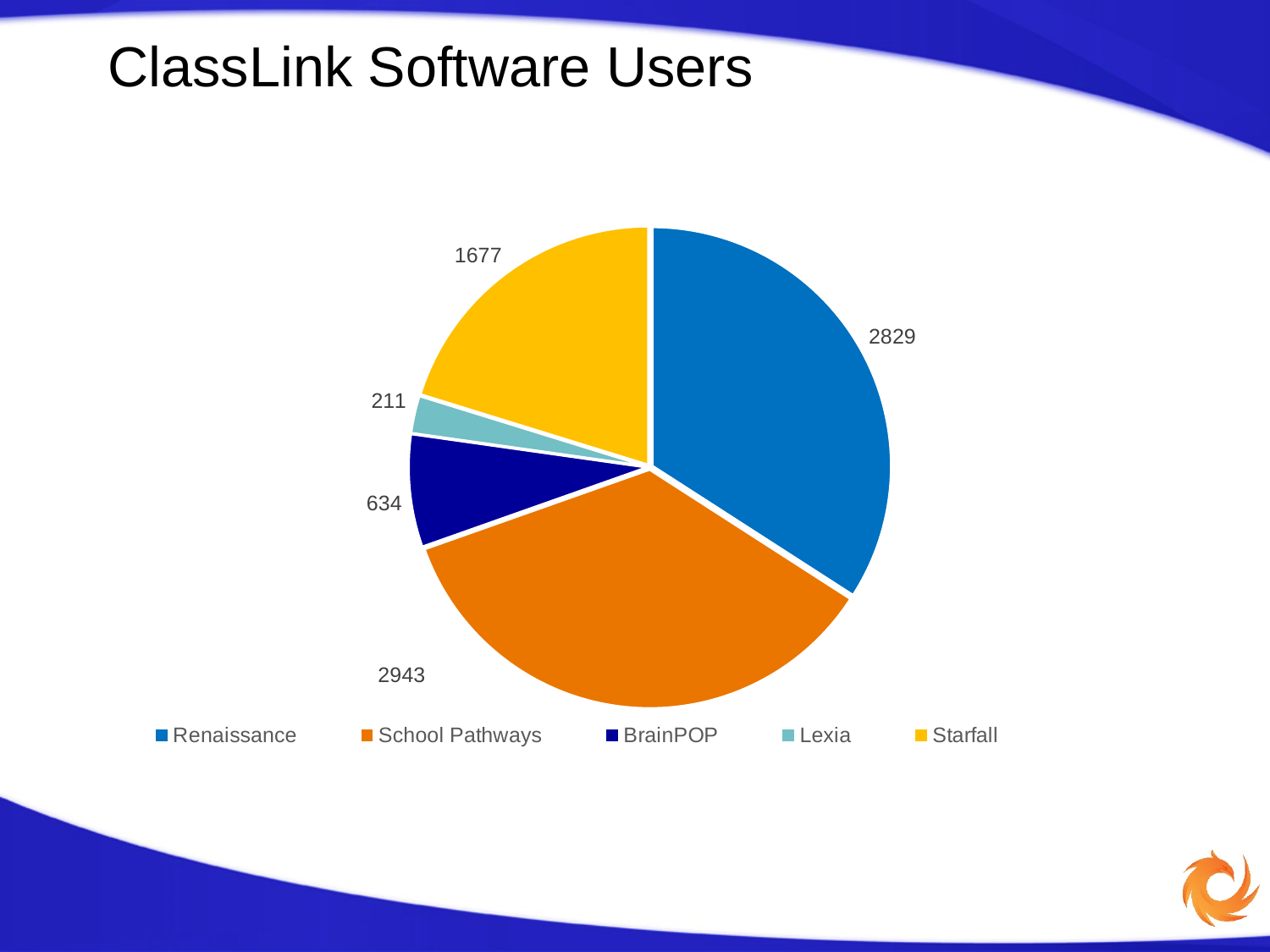
What is the value for Starfall? 1677 What is the value for Lexia? 211 What is the value for School Pathways? 2943 Which software has the most users? School Pathways What is the difference between Starfall and BrainPOP? 1043 What type of chart is shown on the slide? pie chart Which has more users, Starfall or BrainPOP? Starfall How many users does Renaissance have? 2829 What is the title of the slide containing the chart? ClassLink Software Users Which software has the fewest users? Lexia What is the difference between School Pathways and Renaissance? 114 How many slices does the pie chart have? 5